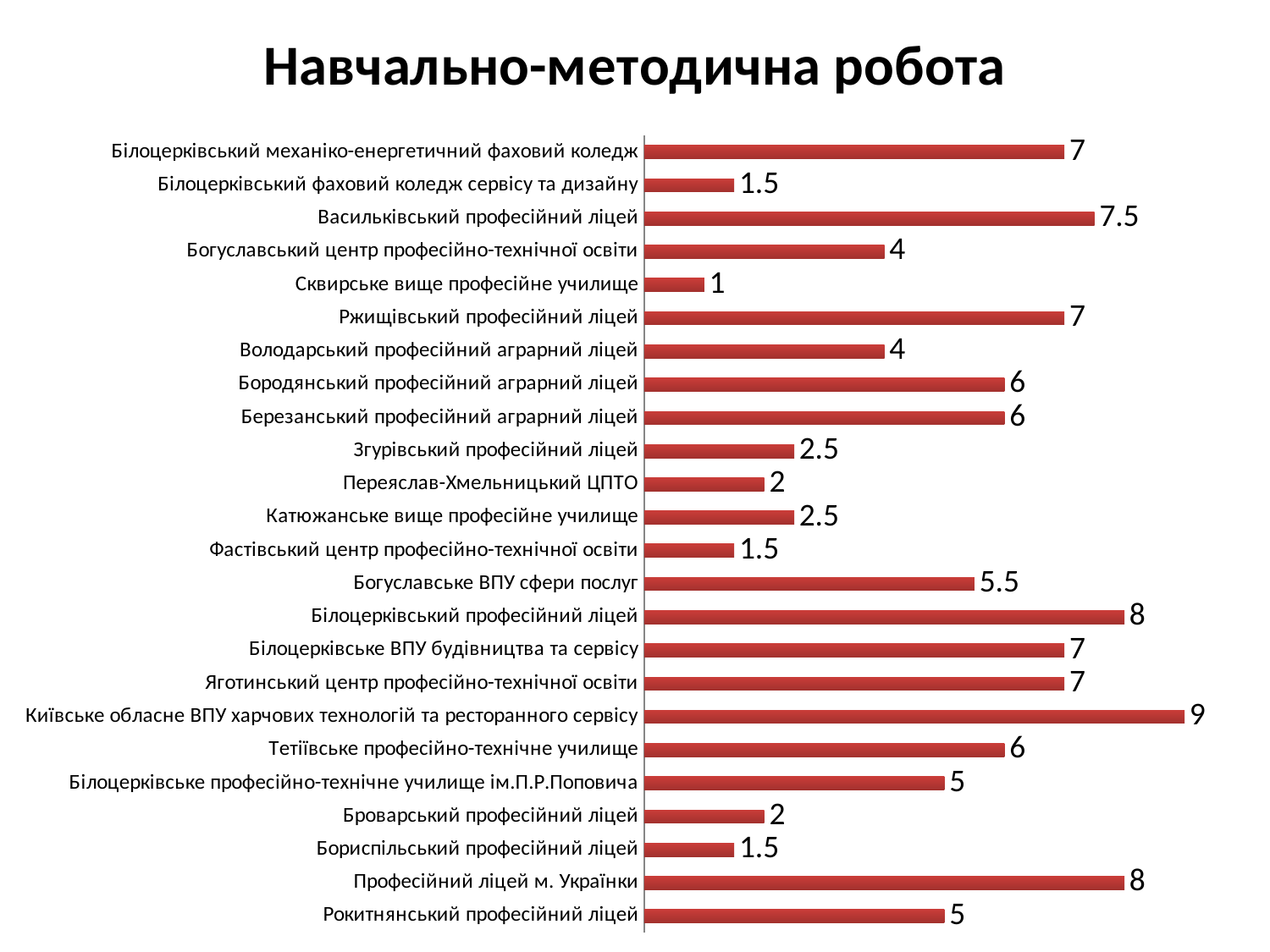
What is the title of the chart? Навчально-методична робота What is the value for Васильківський професійний ліцей? 7.5 How many categories are shown in the chart? 24 What is the difference between the values for Професійний ліцей м. Українки and Бориспільський професійний ліцей? 6.5 What is the value for Переяслав-Хмельницький ЦПТО? 2 What is the value for Рокитнянський професійний ліцей? 5 Which category has the lowest value? Сквирське вище професійне училище Which category has the highest value? Київське обласне ВПУ харчових технологій та ресторанного сервісу What is the difference between the values for Білоцерківський професійний ліцей and Білоцерківський фаховий коледж сервісу та дизайну? 6.5 What is the value for Богуславське ВПУ сфери послуг? 5.5 Which is larger: the value for Тетіївське професійно-технічне училище or the value for Броварський професійний ліцей? Тетіївське професійно-технічне училище What kind of chart is shown on the slide? Bar chart